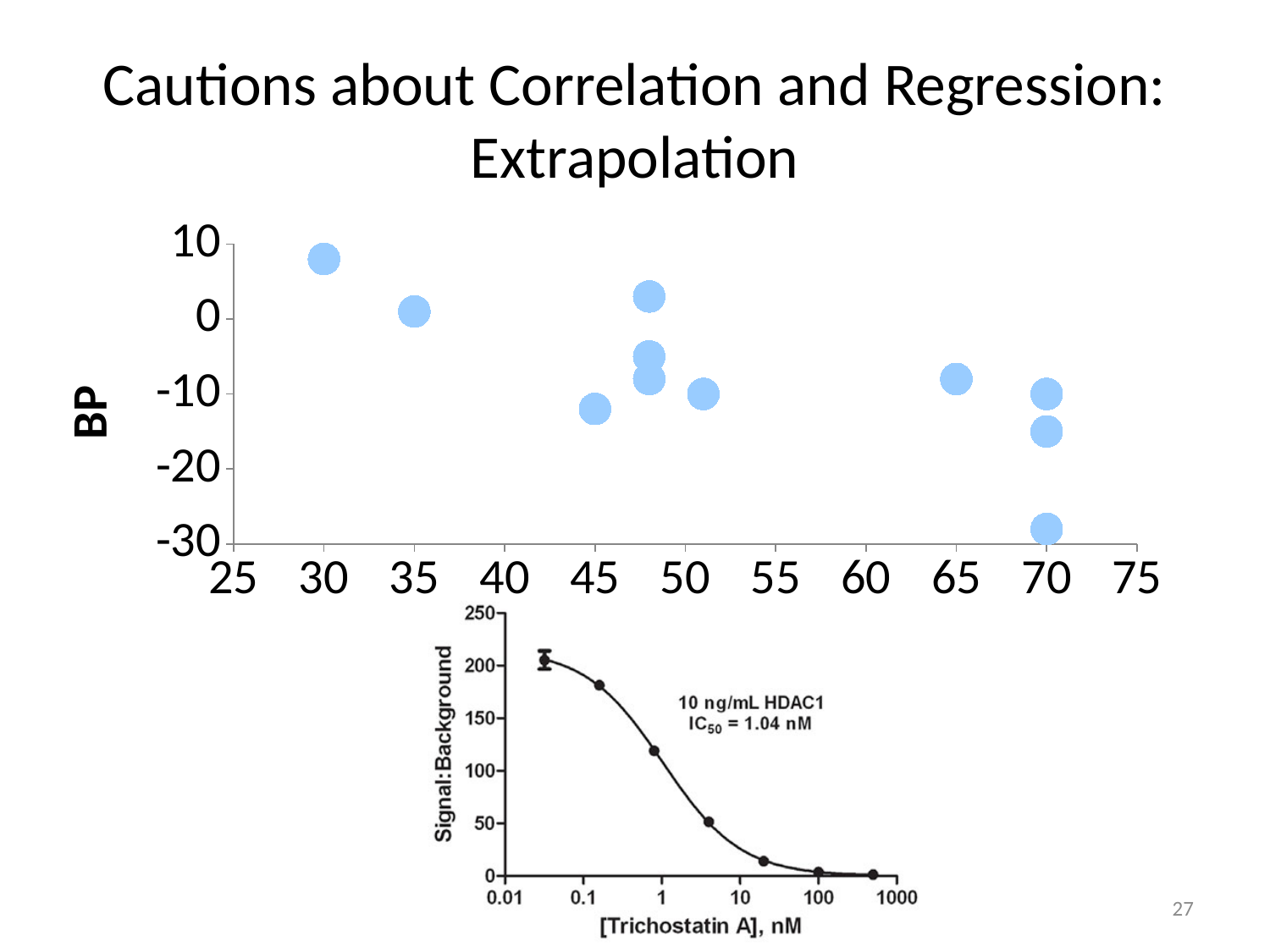
In the bottom chart (Signal:Background vs [Trichostatin A]), is the Signal:Background value at 100 nM greater or less than 50? less What kind of chart is the top chart with the BP axis? scatter plot In the top chart with the BP axis, is the BP value for the point at x = 30 greater or less than 0? greater In the top chart with the BP axis, is the lowest point at x = 70 greater or less than -20? less In the bottom chart (Signal:Background vs [Trichostatin A]), does Signal:Background rise or fall as the Trichostatin A concentration increases? fall How many data points are plotted in the top chart with the BP axis? 11 What is the y-axis label of the top chart? BP What is the x-axis label of the bottom chart? [Trichostatin A], nM In the top chart with the BP axis, do the BP values generally rise or fall as the x-axis value increases? fall How many data points are plotted in the bottom chart (Signal:Background vs [Trichostatin A])? 7 In the bottom chart (Signal:Background vs [Trichostatin A]), what IC50 value is printed on the chart? 1.04 nM